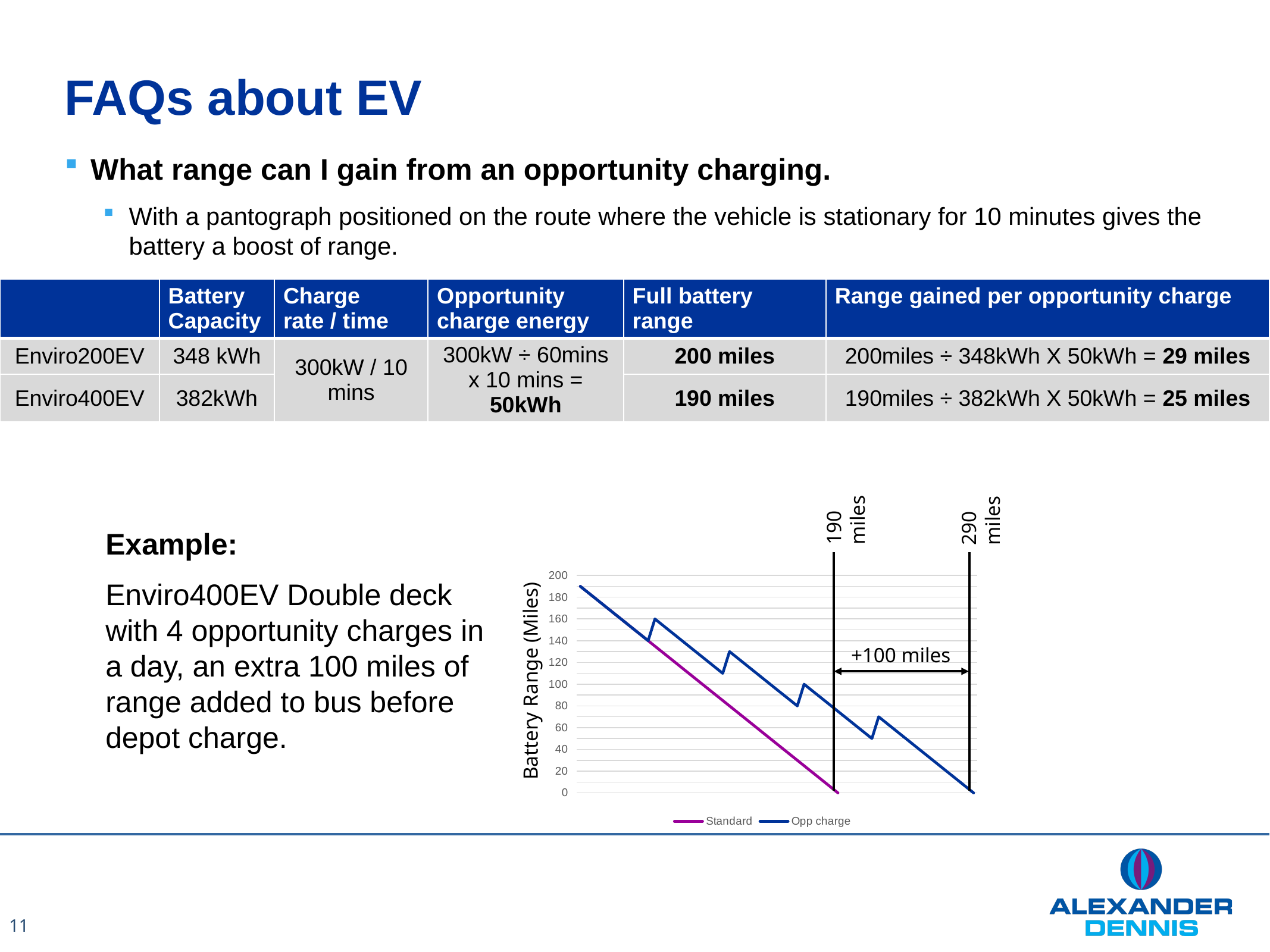
What kind of chart is shown on the slide? line chart Do the values of the Standard series rise or fall along the x axis? fall Is the starting value of the Standard line greater or less than 100? greater What is the title of the chart's vertical axis? Battery Range (Miles) Is the first peak of the Opp charge line after its first recharge greater or less than 140? greater What range is marked at the vertical line where the Opp charge series reaches zero? 290 miles What extra range does the arrow between the two vertical lines on the chart indicate? +100 miles Which series reaches 0 miles further along the x axis, Standard or Opp charge? Opp charge What are the two series named in the chart legend? Standard and Opp charge What is the highest value shown on the chart's vertical axis? 200 What range is marked at the vertical line where the Standard series reaches zero? 190 miles How many series does the chart legend list? 2